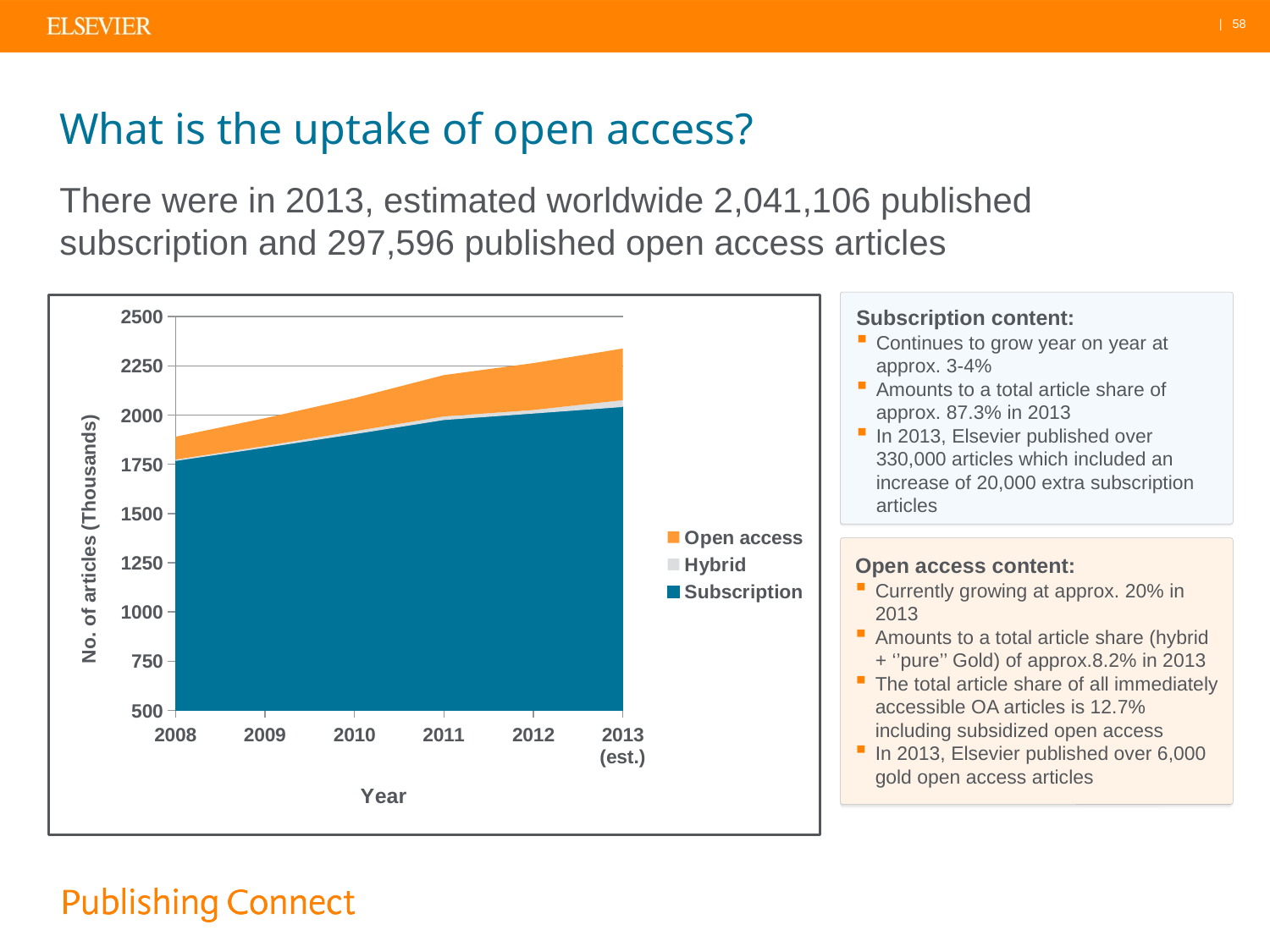
How many years are shown on the x axis of the chart? 6 What is the label of the y axis of the chart? No. of articles (Thousands) Is the Subscription value larger in 2008 or in 2013 (est.)? 2013 (est.) Is the Subscription value for 2013 (est.) greater or less than 2000? greater Is the total number of articles (top of the stacked area) in 2013 (est.) greater or less than 2250? greater What kind of chart is shown on the slide? Stacked area chart Does the total number of articles rise or fall from 2008 to 2013 (est.)? Rise How many series does the chart legend list? 3 Is the total number of articles (top of the stacked area) in 2008 greater or less than 2000? less Which series are listed in the chart legend? Open access, Hybrid, Subscription Which year has the lowest total number of articles in the chart? 2008 Which year has the highest total number of articles in the chart? 2013 (est.)